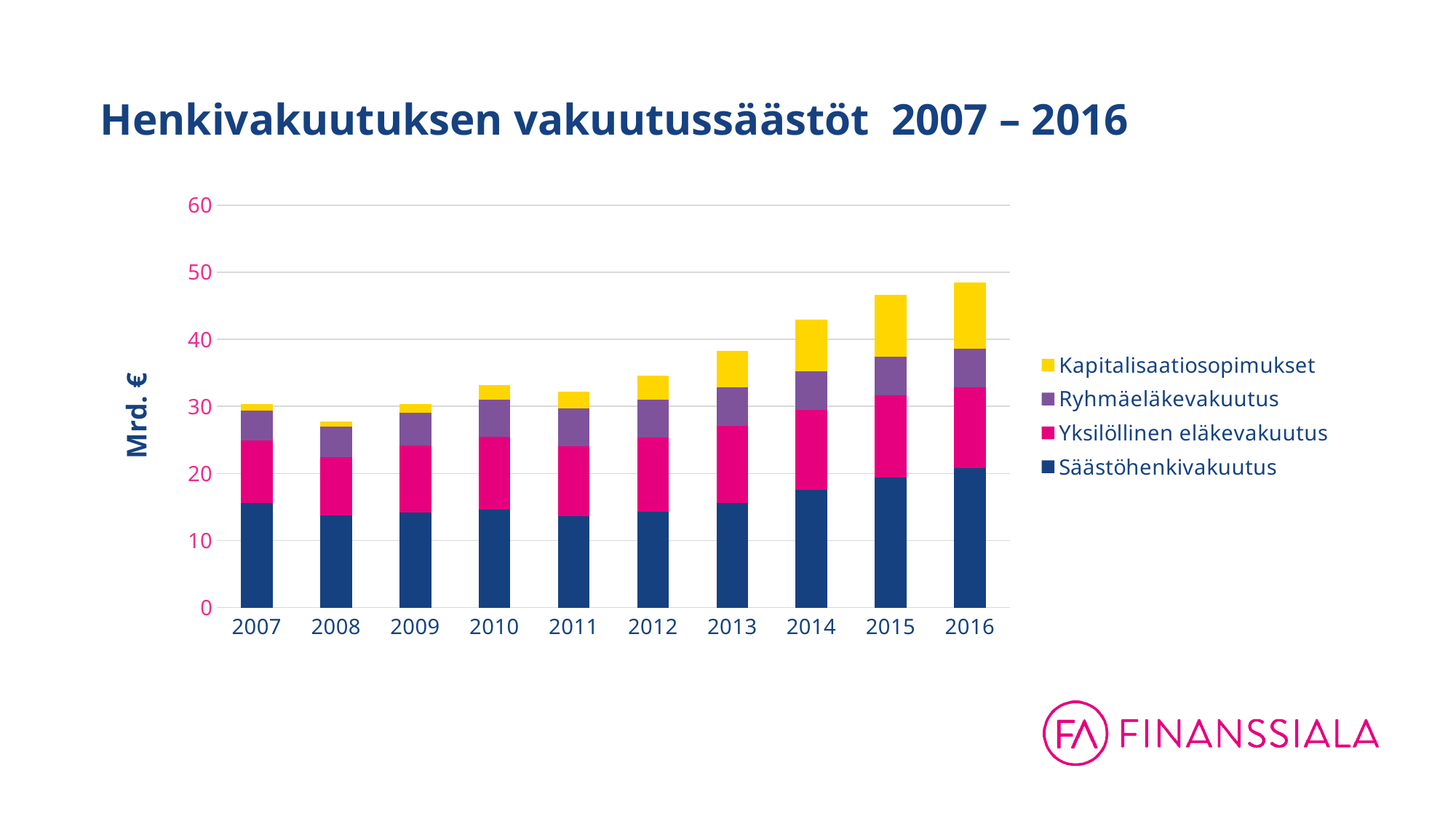
Is the total value for 2012 greater or less than 30? greater Which year has the lowest total bar? 2008 Which year has a larger total bar, 2010 or 2015? 2015 Is the total value for 2008 greater or less than 30? less What kind of chart is shown on the slide? Stacked bar chart Do the total values generally rise or fall from 2007 to 2016? rise What is the label on the y axis of the chart? Mrd. € How many series does the legend list? 4 Is the total value for 2013 greater or less than 40? less How many years are shown on the x axis of the chart? 10 Which year has the highest total bar? 2016